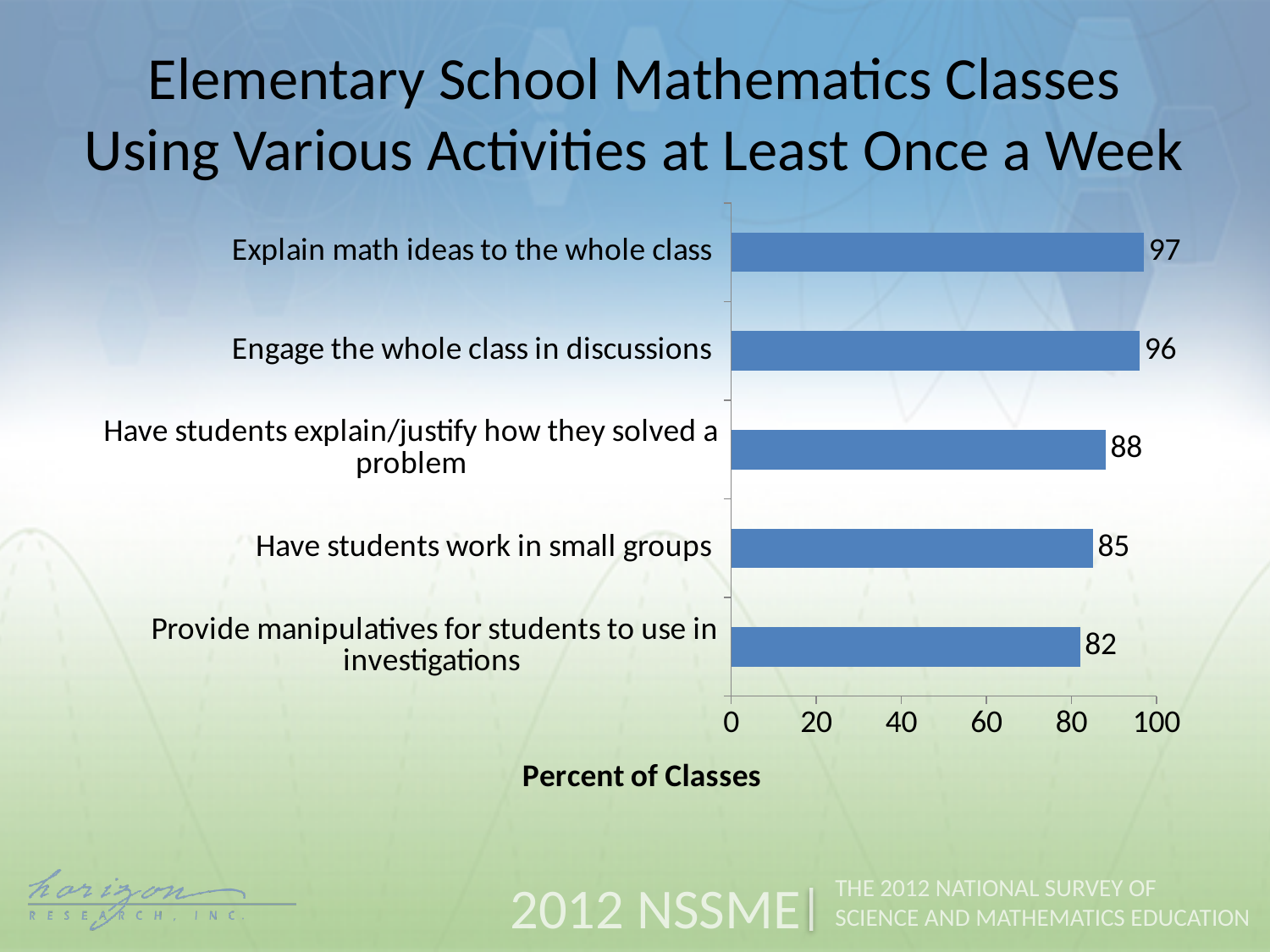
Which is larger: the value for 'Have students work in small groups' or 'Provide manipulatives for students to use in investigations'? Have students work in small groups What is the difference between the highest and lowest values on the chart? 15 What is the label of the horizontal axis? Percent of Classes What is the value for 'Have students work in small groups'? 85 What is the value for 'Provide manipulatives for students to use in investigations'? 82 Is the value for 'Have students explain/justify how they solved a problem' greater or less than 80? greater What is the difference between 'Engage the whole class in discussions' and 'Have students explain/justify how they solved a problem'? 8 Which activity has the lowest percent of classes? Provide manipulatives for students to use in investigations What kind of chart is shown on the slide? Bar chart How many activities are shown on the chart? 5 What percent of classes explain math ideas to the whole class at least once a week? 97 Which activity has the highest percent of classes? Explain math ideas to the whole class